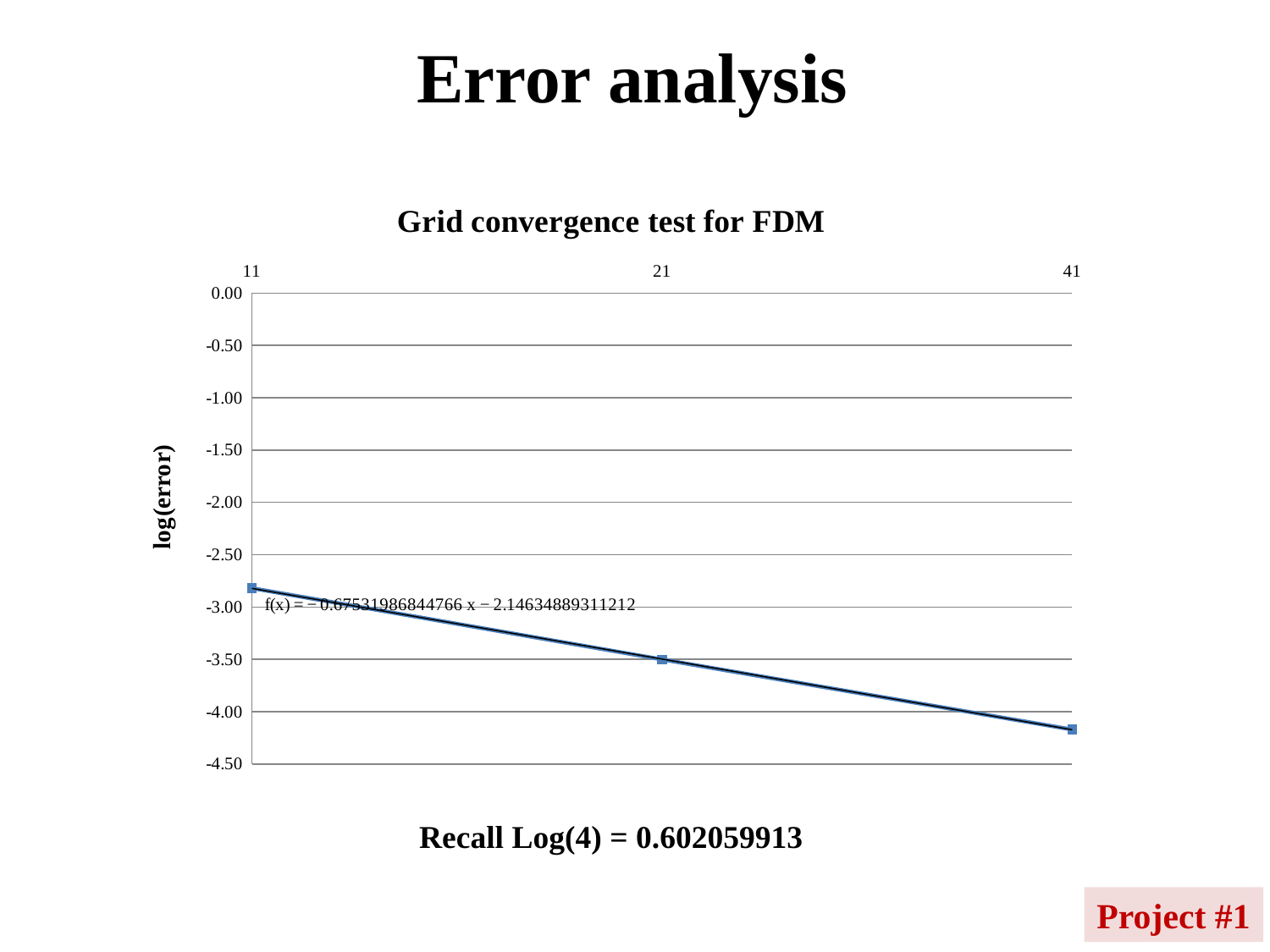
Do the values rise or fall as you move along the x axis from 11 to 41? fall What is the title of the chart? Grid convergence test for FDM What kind of chart is shown on the slide? line chart Is the value for 11 greater or less than -2.50? less Is the value for 11 greater or less than -3.00? greater Which has the larger log(error) value, 21 or 41? 21 What is the label of the vertical axis? log(error) How many data points are plotted on the chart? 3 Which x-axis category has the lowest log(error) value? 41 Which x-axis category has the highest log(error) value? 11 Is the value for 21 greater or less than -3.00? less